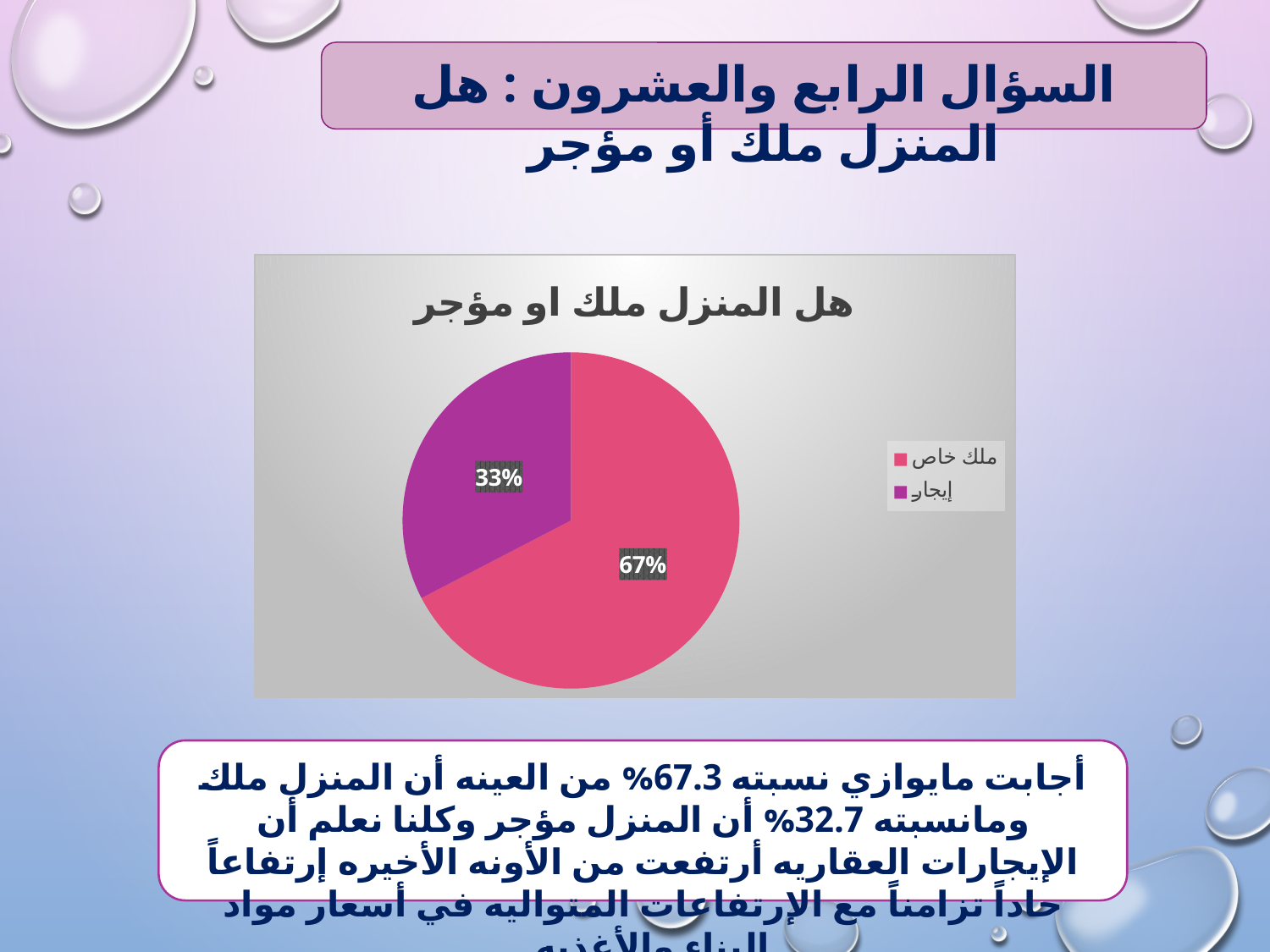
Which category has the largest slice of the pie? ملك خاص What percentage of the pie is labelled for ملك خاص? 67% How many entries does the legend list? 2 How many slices does the pie chart have? 2 Which is larger, the slice for ملك خاص or the slice for إيجار? ملك خاص What is the title of the chart? هل المنزل ملك او مؤجر What colour is the slice for إيجار? purple What kind of chart is shown on the slide? pie chart What share of the pie does the ملك خاص slice represent? 67% What is the difference in percentage points between the ملك خاص slice and the إيجار slice? 34 What percentage of the pie is labelled for إيجار? 33% Which category has the smallest slice of the pie? إيجار